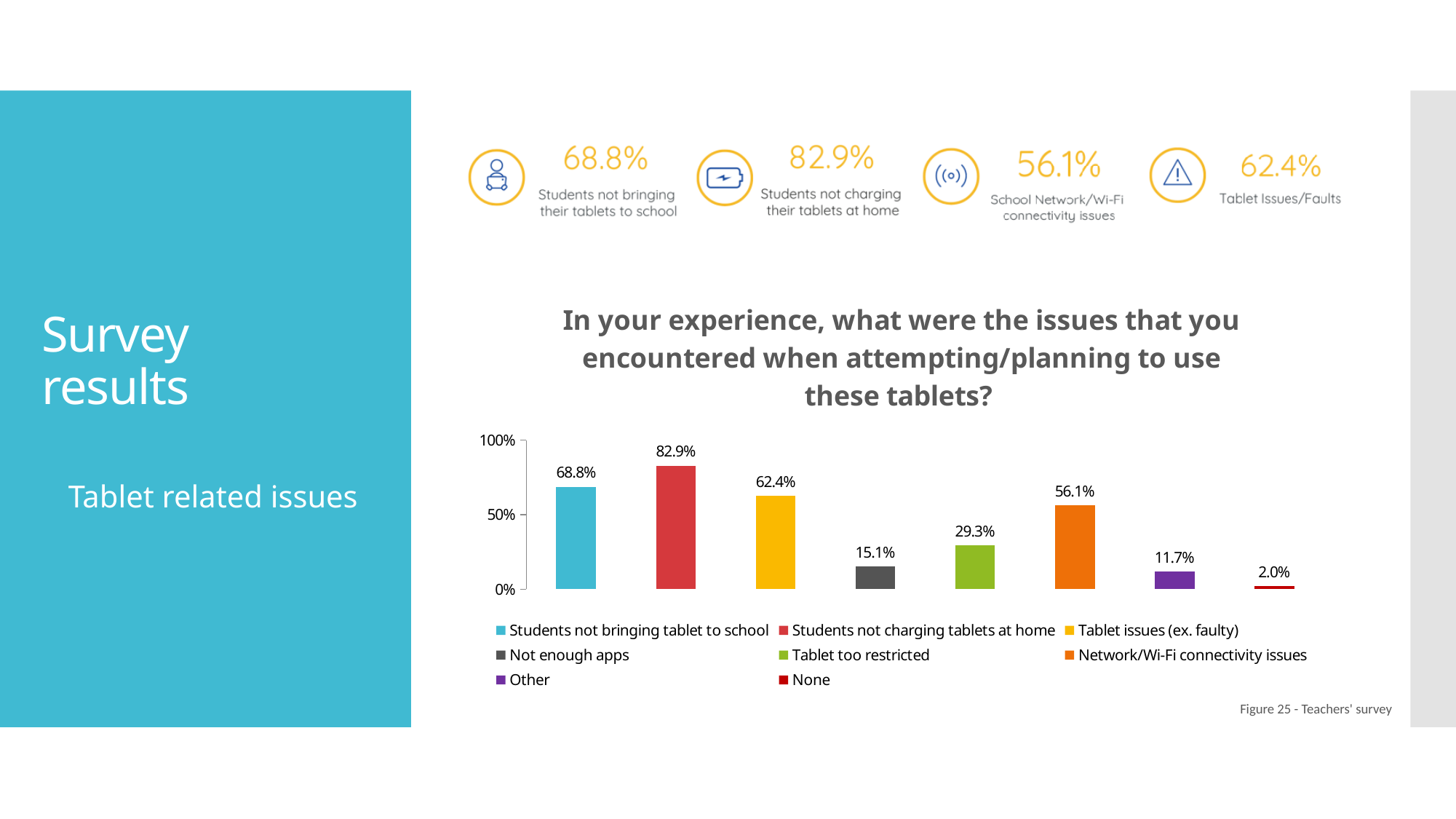
How many categories are plotted in the chart? 8 What percentage of teachers reported students not charging tablets at home as an issue? 82.9% Which is larger: Not enough apps or Other? Not enough apps What colour is the bar for Network/Wi-Fi connectivity issues? Orange What is the difference between the values for Students not bringing tablet to school and Tablet issues (ex. faulty)? 6.4% Which issue has the highest percentage in the chart? Students not charging tablets at home Is the value for Tablet too restricted greater or less than 50%? less How many entries does the legend list? 8 What is the value for Tablet too restricted? 29.3% What is the value for Network/Wi-Fi connectivity issues? 56.1% What type of chart is shown on the slide? Bar chart Which category has the lowest value in the chart? None